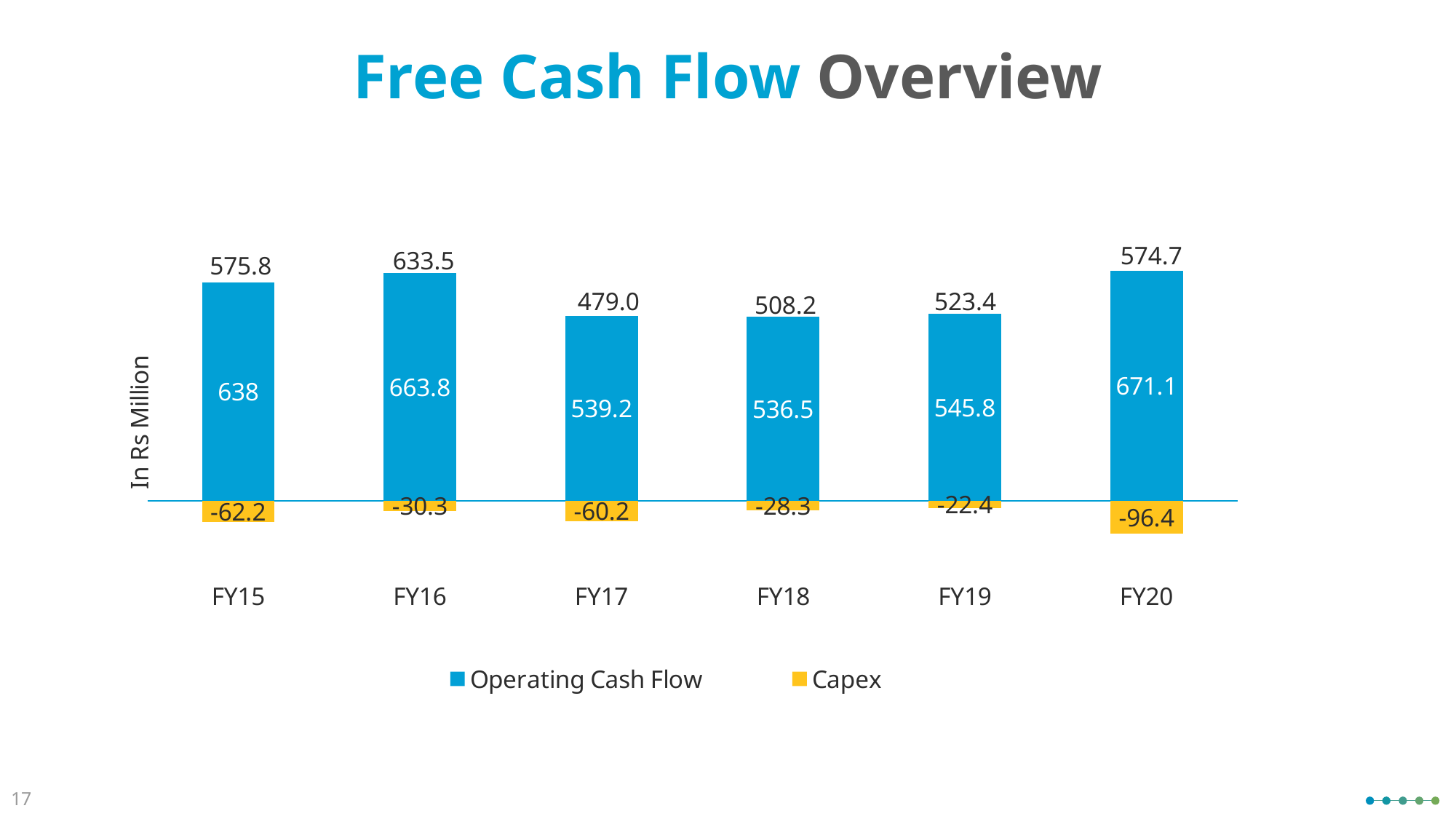
What is the difference between the Operating Cash Flow in FY20 and FY19? 125.3 How many fiscal years are shown on the x axis? 6 What is the total shown above the FY17 bar (Operating Cash Flow plus Capex)? 479.0 How many series does the legend list? 2 What is the Operating Cash Flow value for FY18? 536.5 Which fiscal year has the highest Operating Cash Flow? FY20 Is the Operating Cash Flow larger in FY15 or FY17? FY15 What is the Operating Cash Flow value for FY16? 663.8 What type of chart is shown on the slide? Stacked bar chart What is the Capex value for FY20? -96.4 Which fiscal year has the lowest Operating Cash Flow? FY18 Which fiscal year has the smallest Capex in absolute terms? FY19